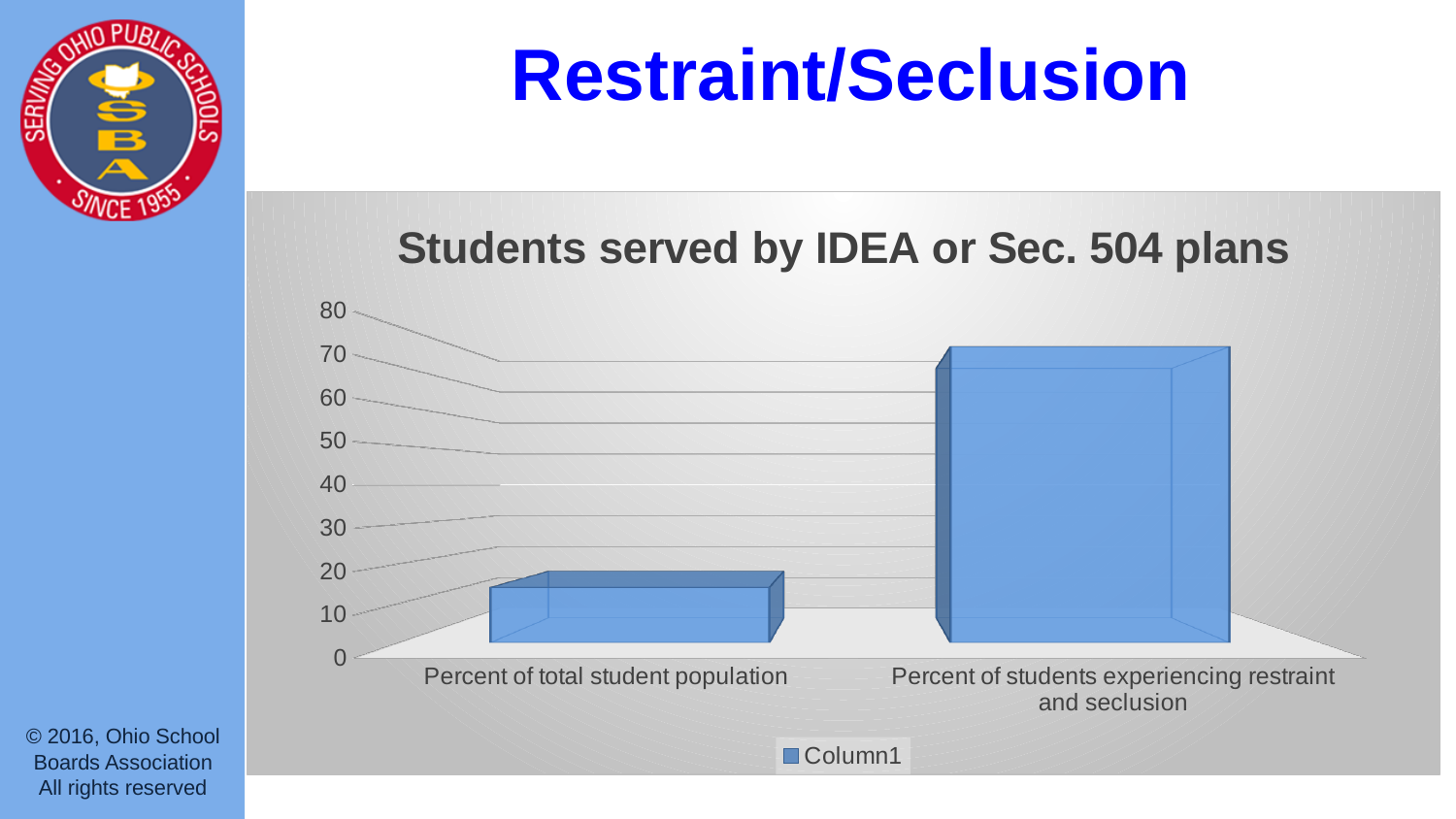
Which is larger: the value for Percent of total student population or the value for Percent of students experiencing restraint and seclusion? Percent of students experiencing restraint and seclusion Is the value for Percent of students experiencing restraint and seclusion greater or less than 80? less Do the bar values rise or fall from left to right along the x axis? rise What kind of chart is shown on the slide? bar chart Is the value for Percent of students experiencing restraint and seclusion greater or less than 60? greater What is the legend entry shown below the chart? Column1 Is the value for Percent of total student population greater or less than 20? less How many bars are plotted in the chart? 2 How many series does the legend list? 1 Which category has the highest bar? Percent of students experiencing restraint and seclusion Which category has the lowest bar? Percent of total student population What is the title of the chart? Students served by IDEA or Sec. 504 plans